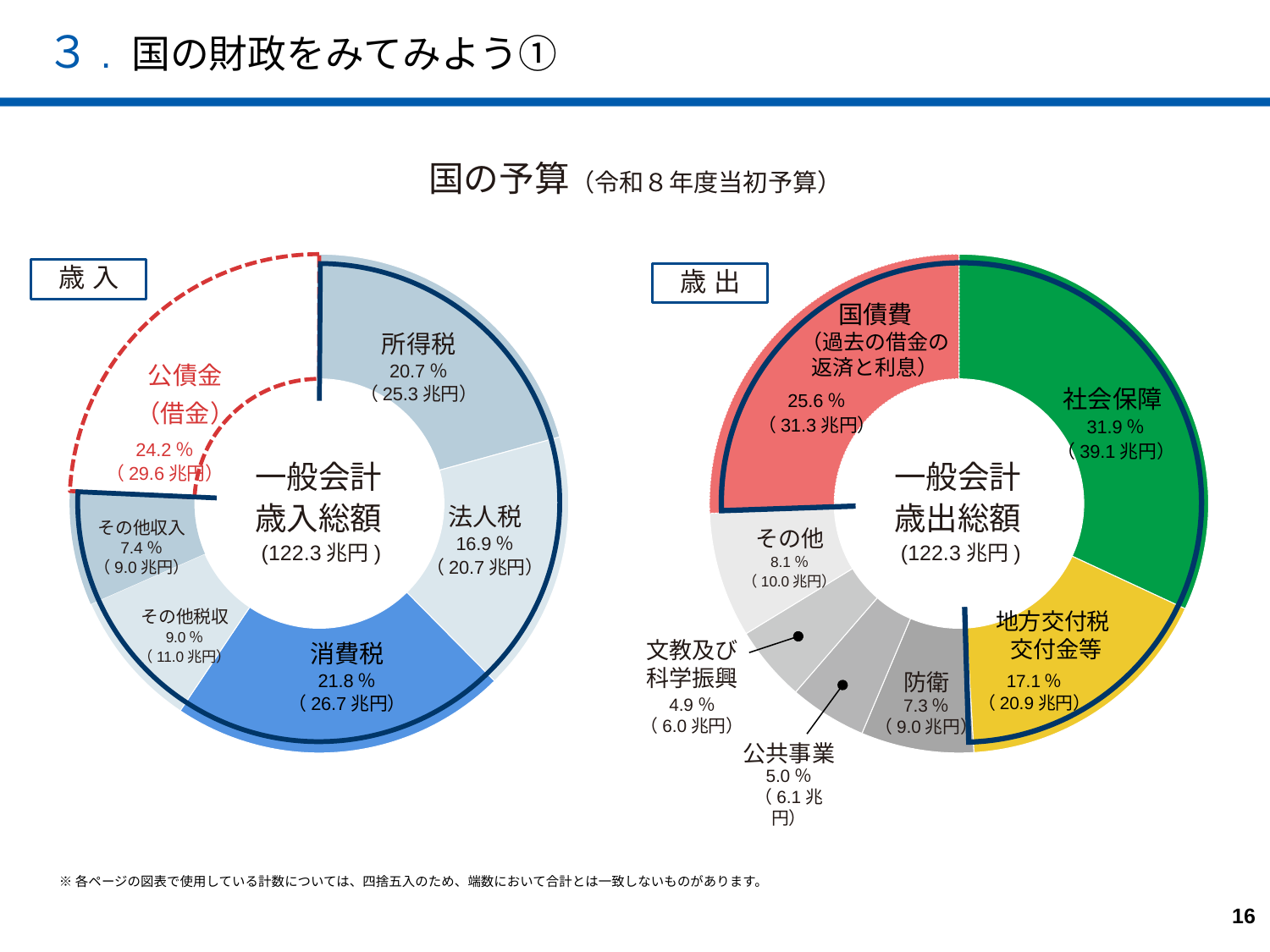
歳出の円グラフで、最も割合が大きい項目はどれですか。 社会保障 このスライドのグラフはどのような種類のグラフですか。 円グラフ（ドーナツグラフ） 歳入の円グラフで、最も割合が小さい項目はどれですか。 その他収入 歳入の円グラフには、いくつの項目がありますか。 6 歳出の円グラフで、国債費と地方交付税交付金等では、どちらの割合が大きいですか。 国債費 歳出の円グラフで、防衛の割合は何％ですか。 7.3％ 歳入の円グラフで、所得税と法人税の金額の差はいくらですか。 4.6兆円 歳入の円グラフで、公債金（借金）の金額はいくらですか。 29.6兆円 歳入の円グラフで、消費税の割合は何％ですか。 21.8％ 歳出の円グラフには、いくつの項目がありますか。 7 歳出の円グラフで、最も割合が小さい項目はどれですか。 文教及び科学振興 歳出の円グラフで、社会保障の金額はいくらですか。 39.1兆円